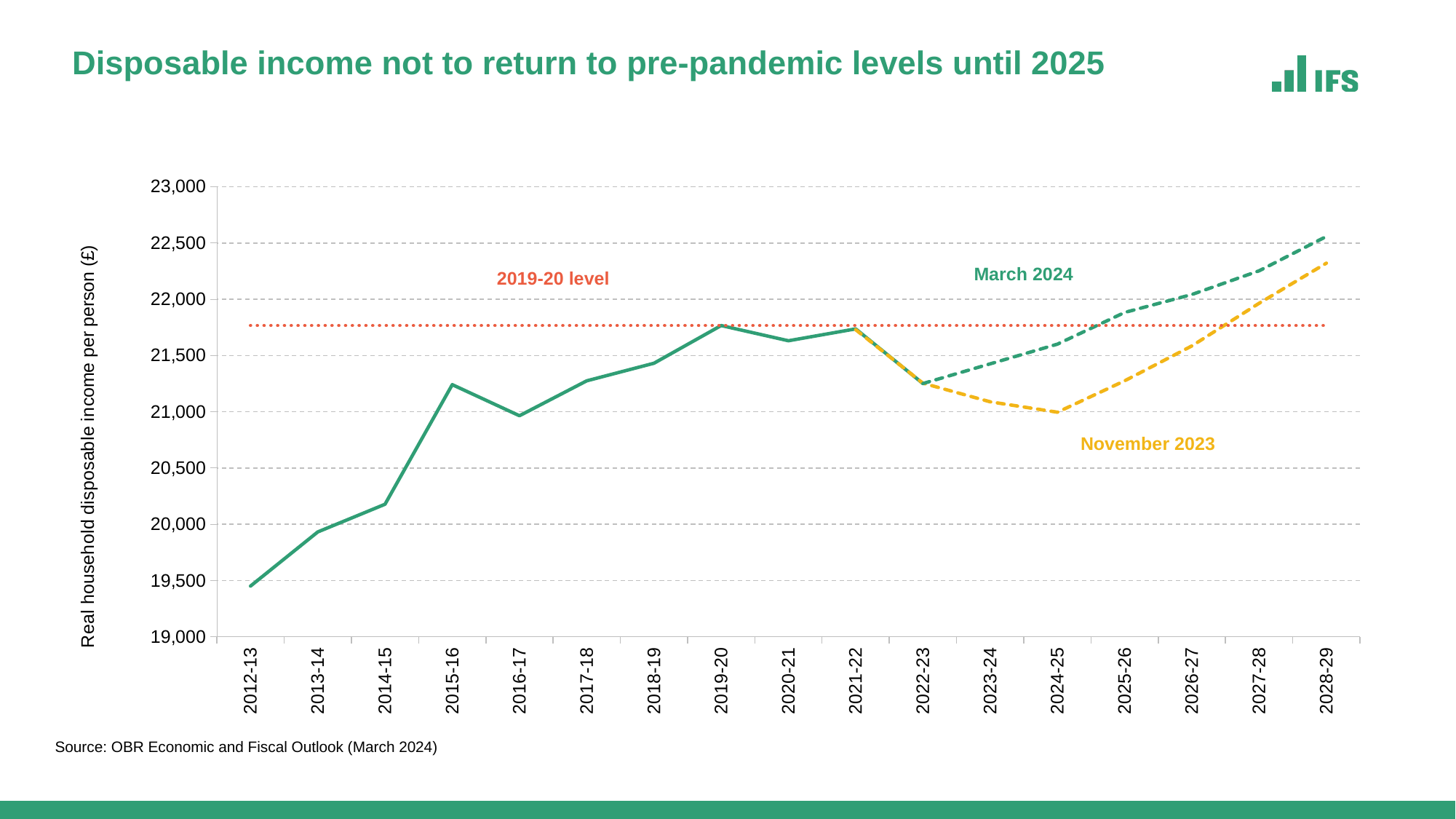
Is the value for 2012-13 greater or less than 19,500? less Is the November 2023 forecast value for 2028-29 greater or less than 22,000? greater Is the value for 2014-15 greater or less than 20,000? greater Which is larger, the value for 2019-20 or the value for 2016-17? 2019-20 In 2024-25, which forecast is higher, March 2024 or November 2023? March 2024 What does the horizontal red dotted line on the chart represent? 2019-20 level Does real household disposable income per person rise or fall from 2012-13 to 2015-16? rise How many financial years are shown on the x axis? 17 What kind of chart is shown on the slide? line chart Which year has the lowest real household disposable income per person on the chart? 2012-13